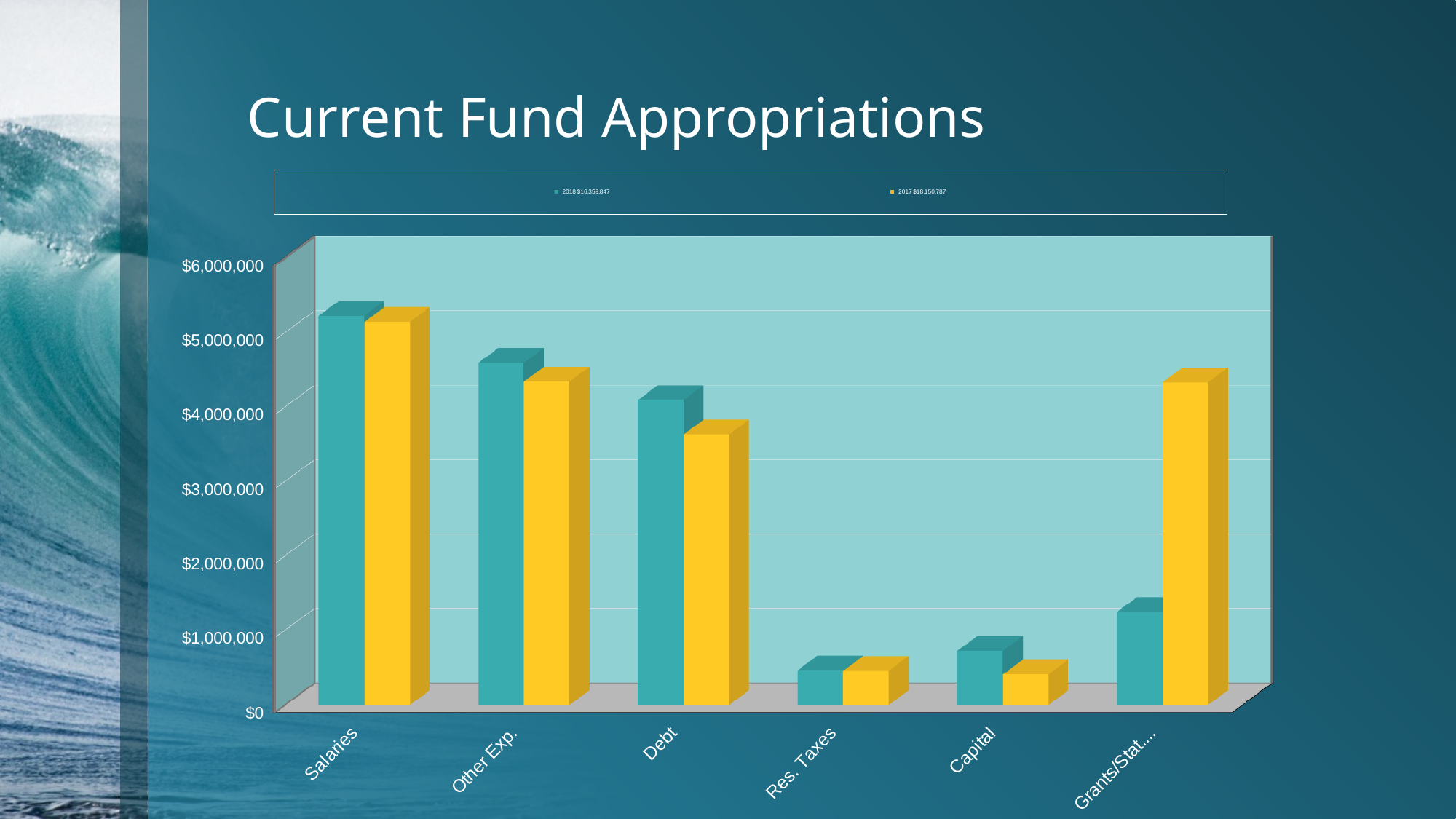
Is the 2017 value for Debt greater or less than $4,000,000? less How many categories are shown on the x axis of the chart? 6 What total is shown in the legend entry for the 2018 series? $16,359,847 For Grants/Stat...., which series has the larger value, 2018 or 2017? 2017 Is the 2017 value for Grants/Stat.... greater or less than $4,000,000? greater Which category has the highest 2018 value? Salaries What is the title of the slide containing the chart? Current Fund Appropriations How many series does the chart's legend list? 2 Is the 2018 value for Salaries greater or less than $5,000,000? greater Which category has the lowest 2017 value? Capital What kind of chart is shown on the slide? bar chart